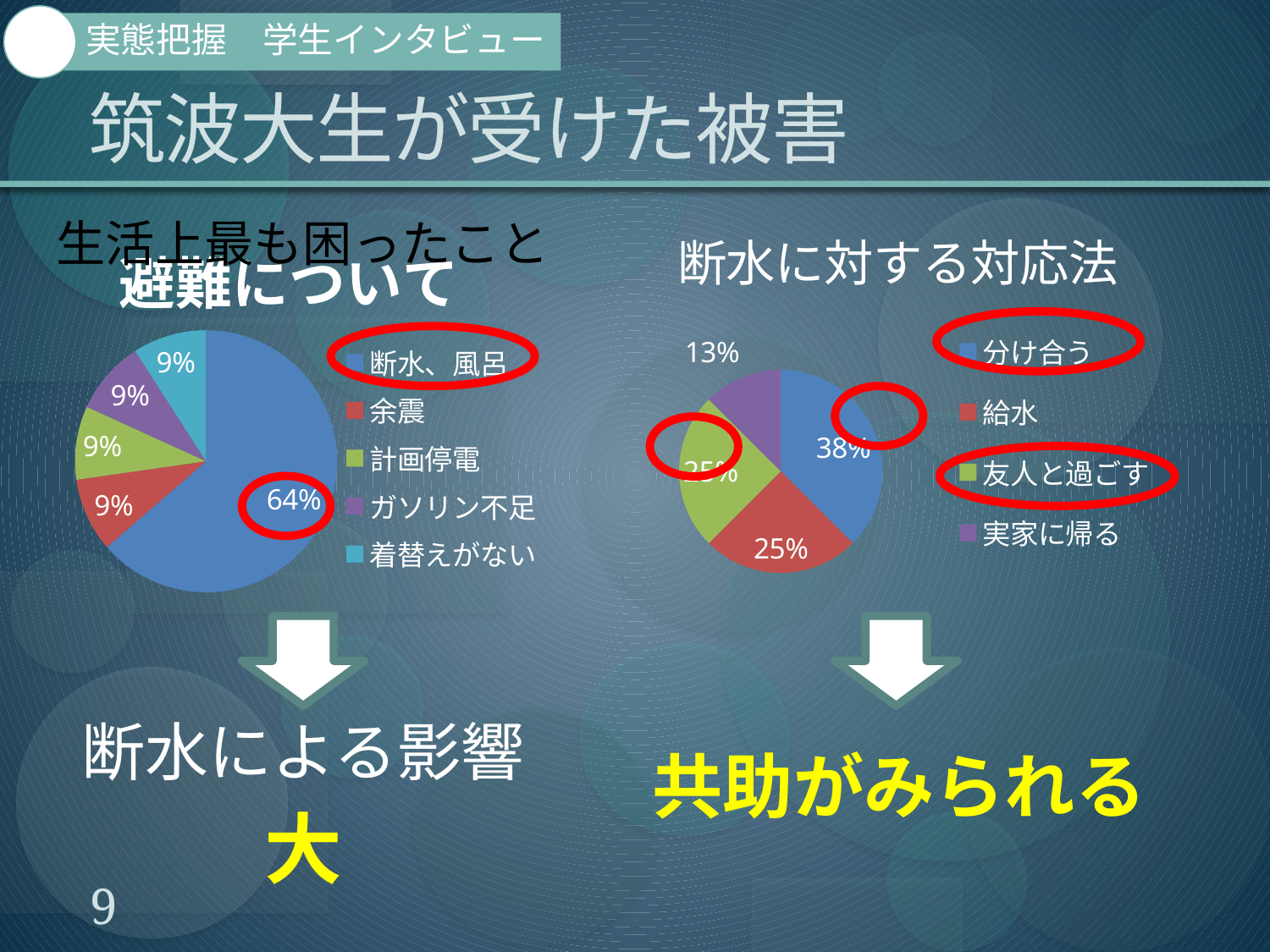
How many categories does the legend of the right chart (断水に対する対応法) list? 4 In the right chart (断水に対する対応法), what colour is the slice for 友人と過ごす? green In the right chart (断水に対する対応法), what share does 分け合う have? 38% In the right chart (断水に対する対応法), which is larger, the share for 分け合う or the share for 給水? 分け合う What kind of chart is the left chart (生活上最も困ったこと)? pie chart In the right chart (断水に対する対応法), what share does 実家に帰る have? 13% In the right chart (断水に対する対応法), which category has the smallest share? 実家に帰る How many categories does the legend of the left chart (生活上最も困ったこと) list? 5 In the left chart (生活上最も困ったこと), which category has the largest share? 断水、風呂 In the left chart (生活上最も困ったこと), what is the difference between the share for 断水、風呂 and the share for 計画停電? 55% In the left chart (生活上最も困ったこと), what share does 断水、風呂 have? 64% In the left chart (生活上最も困ったこと), what share does 余震 have? 9%